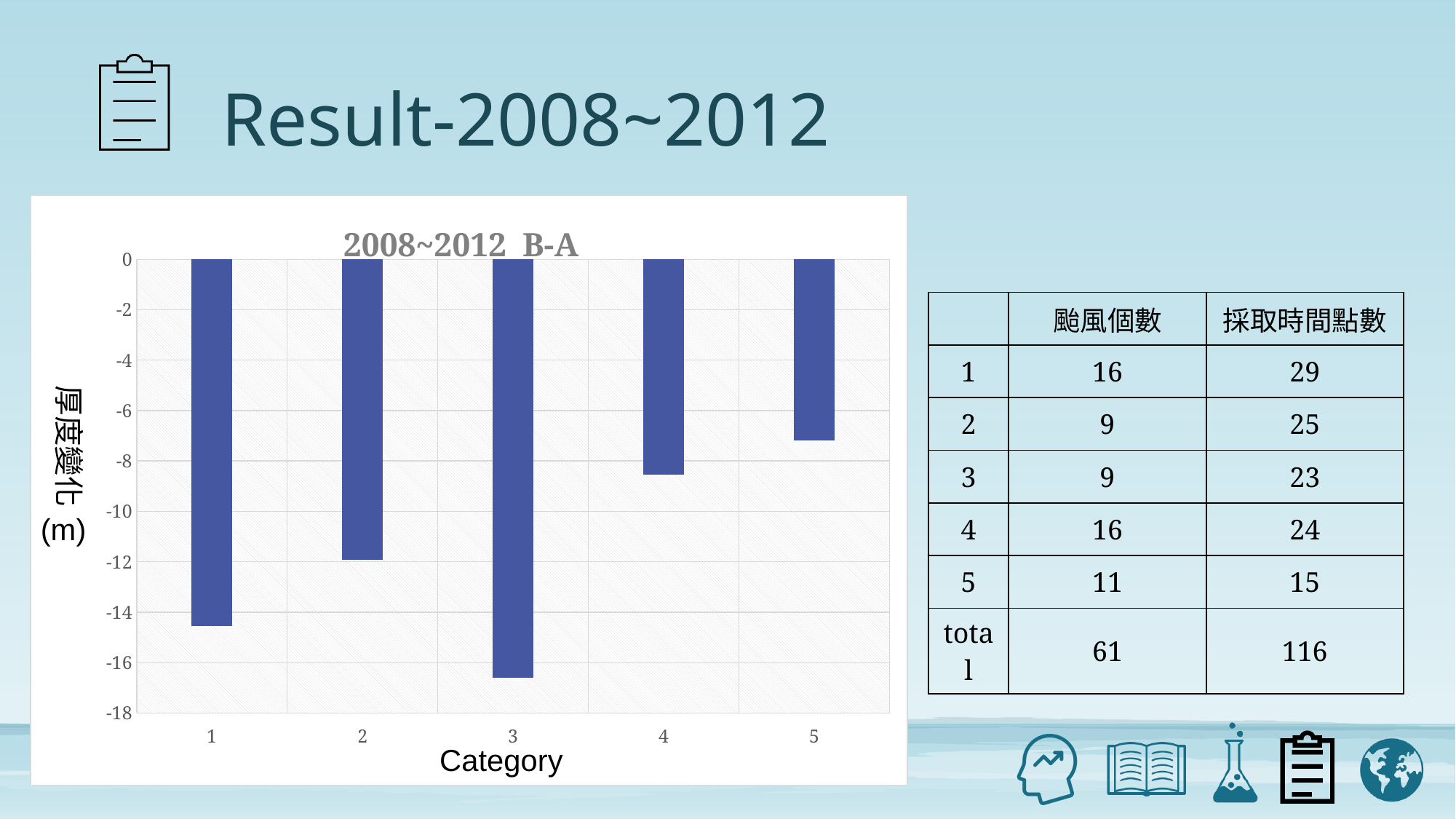
What is the title of the chart? 2008~2012 B-A Which has the larger (less negative) value, category 1 or category 2? 2 What is the label of the x axis of the chart? Category What kind of chart is shown on the slide? bar chart Is the value for category 3 greater or less than -16? less Which has the larger (less negative) value, category 4 or category 3? 4 Is the value for category 5 greater or less than -8? greater Is the value for category 4 greater or less than -8? less Which category has the highest (least negative) value in the chart? 5 Which category has the lowest (most negative) value in the chart? 3 How many categories are plotted in the chart? 5